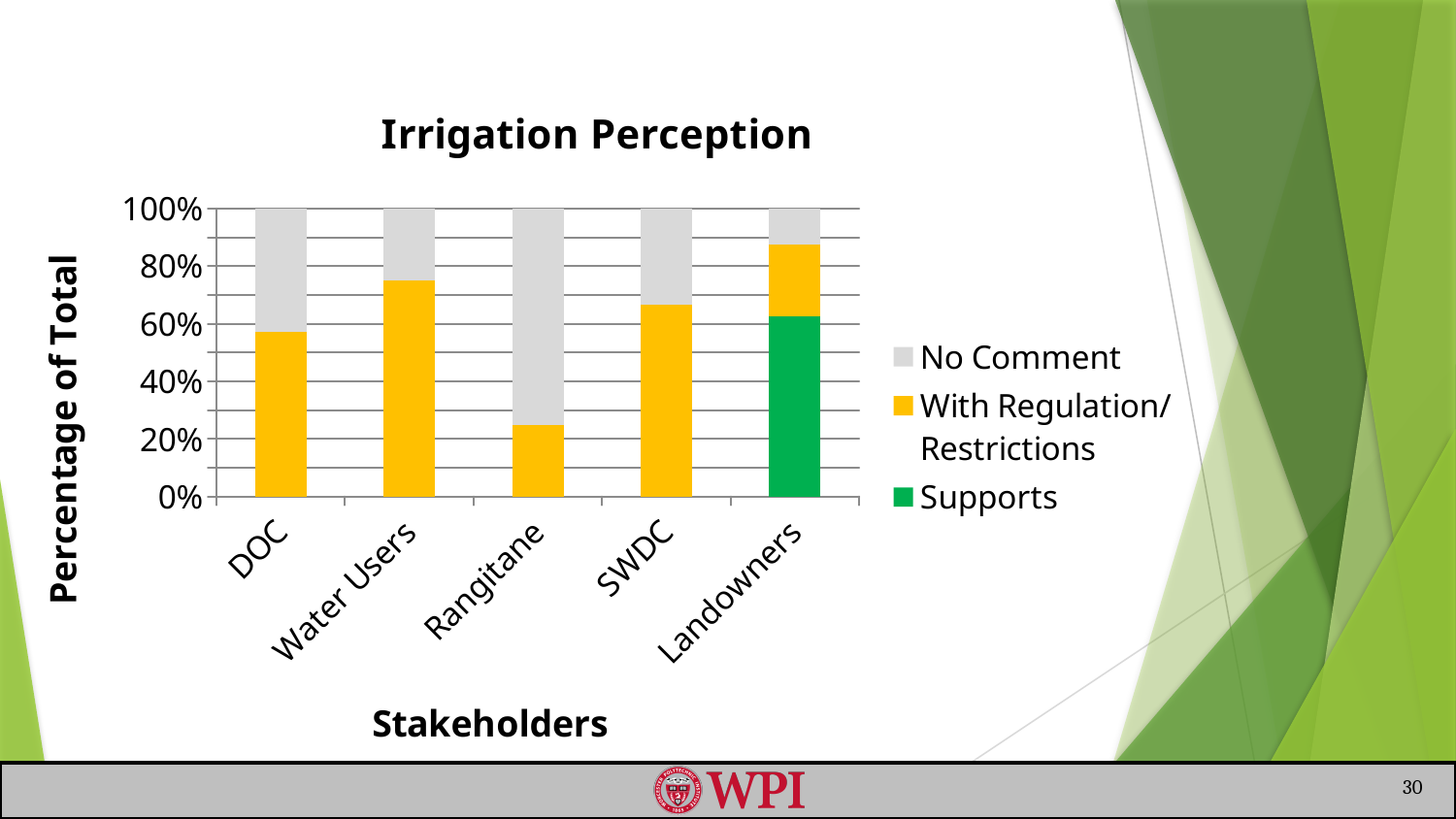
Which stakeholder has the largest No Comment share? Rangitane Is the Supports share for Landowners greater or less than 40%? greater What is the title of the chart? Irrigation Perception Which stakeholder has the largest With Regulation/Restrictions share? Water Users What kind of chart is shown on the slide? Stacked bar chart Is the With Regulation/Restrictions share for Rangitane greater or less than 40%? less How many series does the legend list? 3 Which stakeholder is the only one with a Supports segment? Landowners How many stakeholder categories are shown on the x axis? 5 What is the label of the vertical axis? Percentage of Total Is the With Regulation/Restrictions share for DOC or for Water Users larger? Water Users